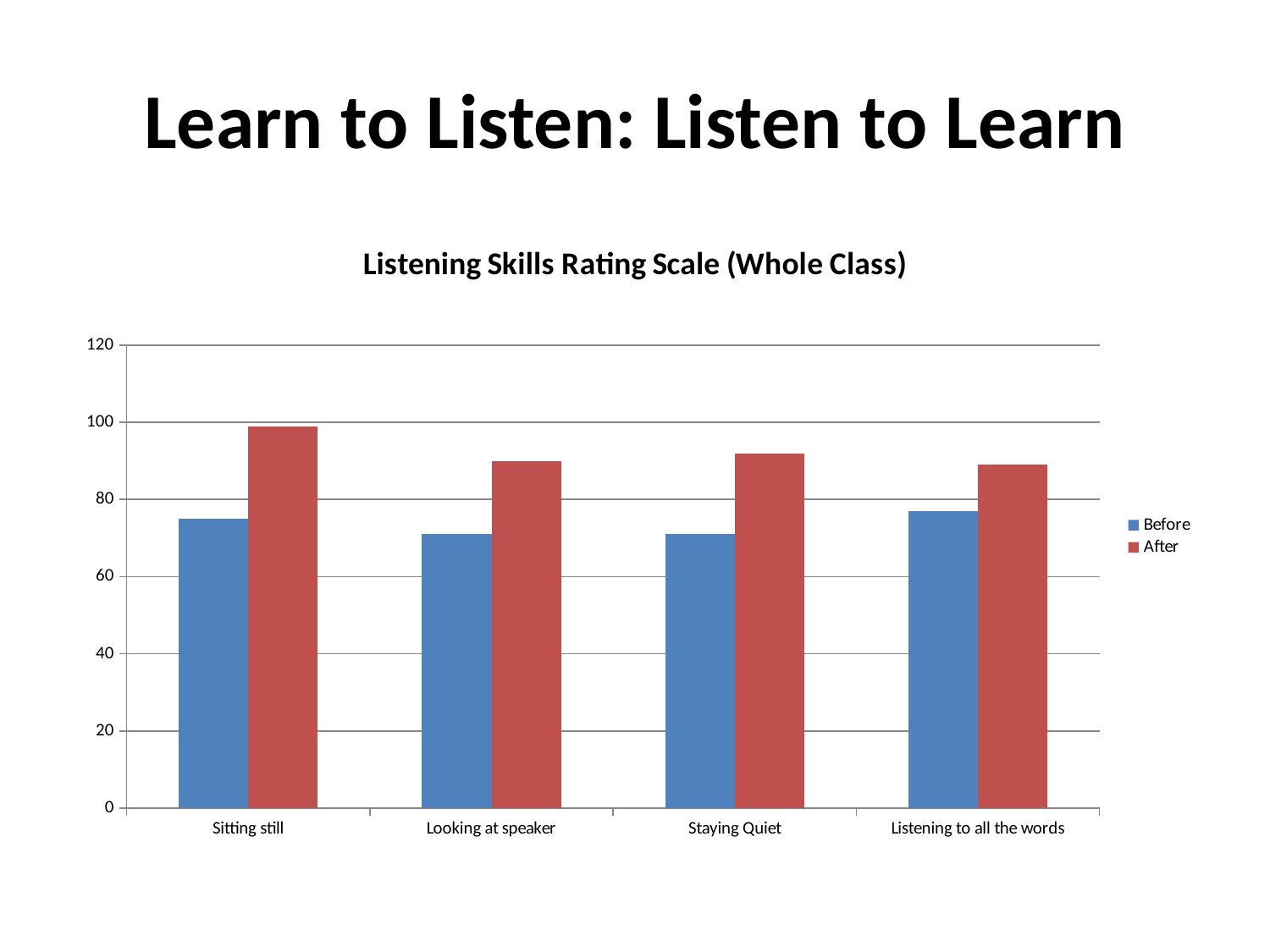
Is the After value for Sitting still greater or less than 80? greater For Looking at speaker, which is larger, the Before value or the After value? After Is the Before value for Sitting still greater or less than 80? less Is the After value for Staying Quiet greater or less than 80? greater How many categories are shown on the x axis? 4 What is the title of the chart? Listening Skills Rating Scale (Whole Class) Which category has the highest After value? Sitting still For Listening to all the words, which is larger, the Before value or the After value? After What kind of chart is shown on the slide? bar chart How many series does the legend list? 2 Which colour represents the After series in the legend? red